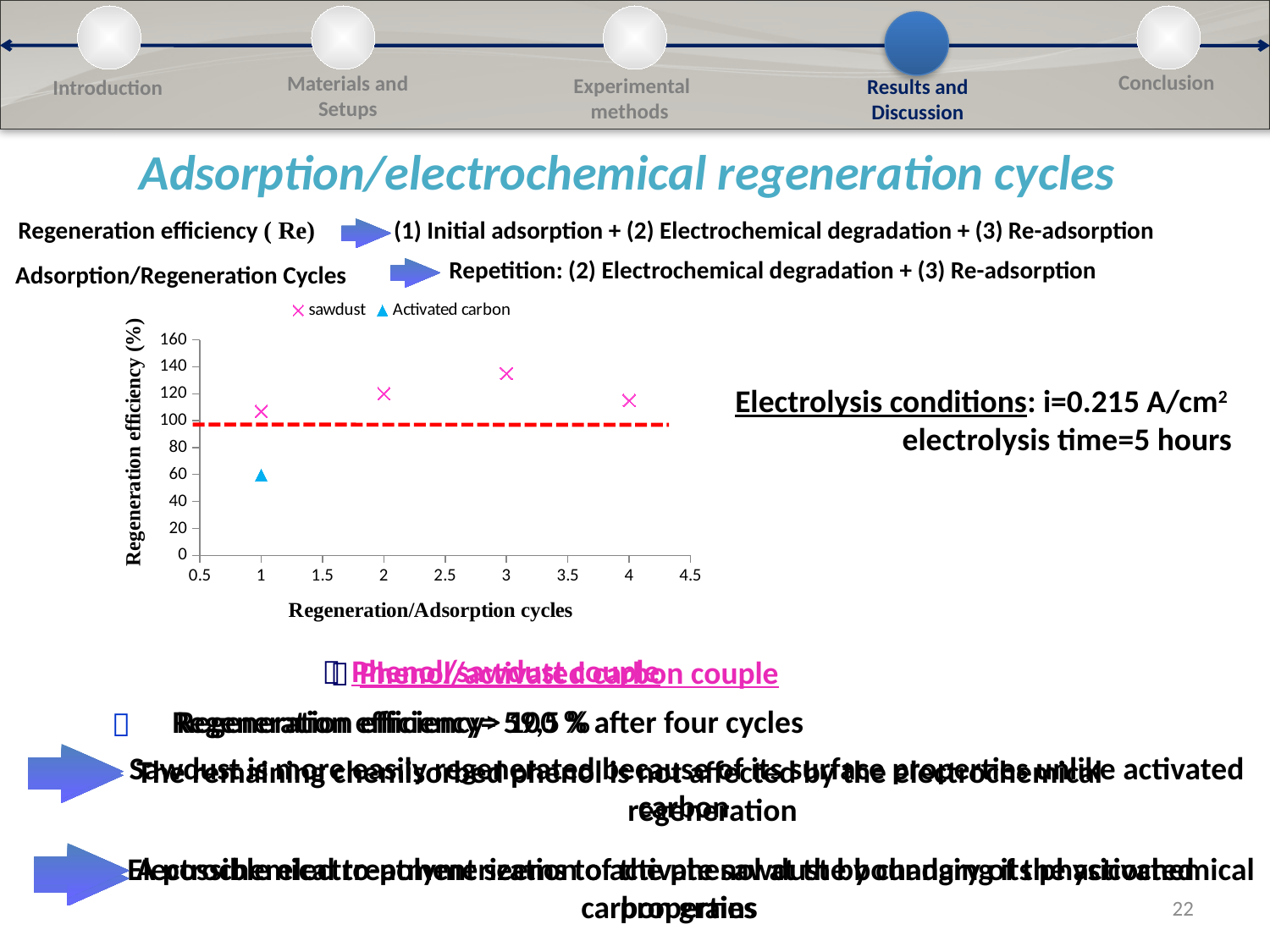
At cycle 1, which series has the higher regeneration efficiency, sawdust or Activated carbon? sawdust How many data points are plotted for the sawdust series? 4 Is the regeneration efficiency for sawdust at cycle 3 greater or less than 120? greater What are the two series named in the chart legend? sawdust and Activated carbon At which regeneration/adsorption cycle does the sawdust series reach its highest regeneration efficiency? 3 How many data points are plotted for the Activated carbon series? 1 How many series does the chart legend list? 2 Is the regeneration efficiency for sawdust at cycle 2 greater or less than 100? greater What is the label of the chart's x axis? Regeneration/Adsorption cycles Does the regeneration efficiency for sawdust rise or fall from cycle 1 to cycle 3? rise Is the regeneration efficiency for Activated carbon at cycle 1 greater or less than 80? less What kind of chart is shown on the slide? scatter chart